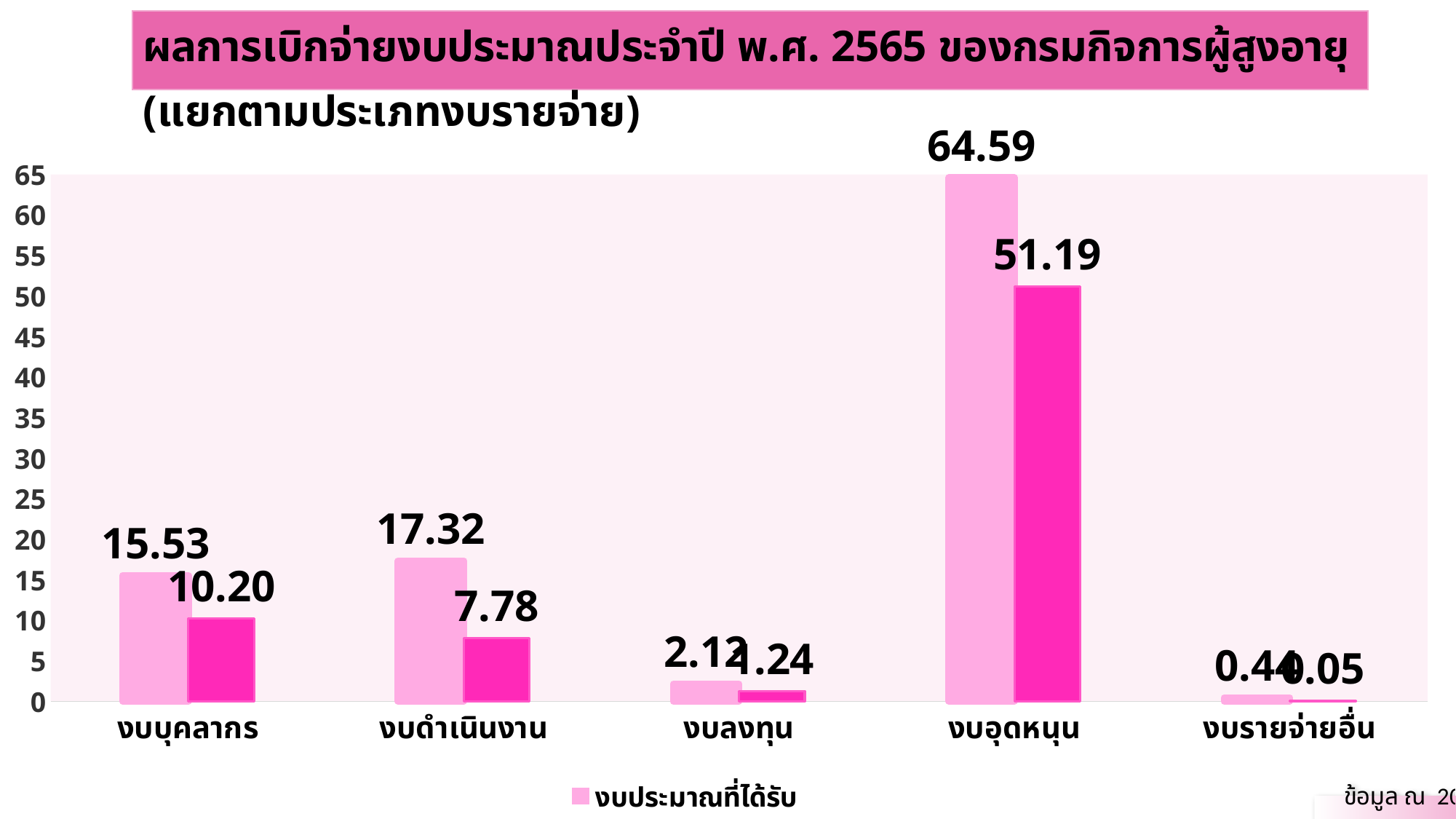
Which category has the lowest งบประมาณที่ได้รับ value? งบรายจ่ายอื่น What is the งบประมาณที่ได้รับ value for งบบุคลากร? 15.53 What is the value of the darker pink bar for งบอุดหนุน? 51.19 What is the value of the darker pink bar for งบบุคลากร? 10.20 Which category has the highest งบประมาณที่ได้รับ value? งบอุดหนุน What is the งบประมาณที่ได้รับ value for งบดำเนินงาน? 17.32 What kind of chart is shown on the slide? bar chart What is the difference between the two bars for งบอุดหนุน (64.59 and 51.19)? 13.40 Which has the larger งบประมาณที่ได้รับ value, งบบุคลากร or งบดำเนินงาน? งบดำเนินงาน What is the value of the darker pink bar for งบดำเนินงาน? 7.78 How many categories are shown on the x axis? 5 What is the งบประมาณที่ได้รับ value for งบอุดหนุน? 64.59